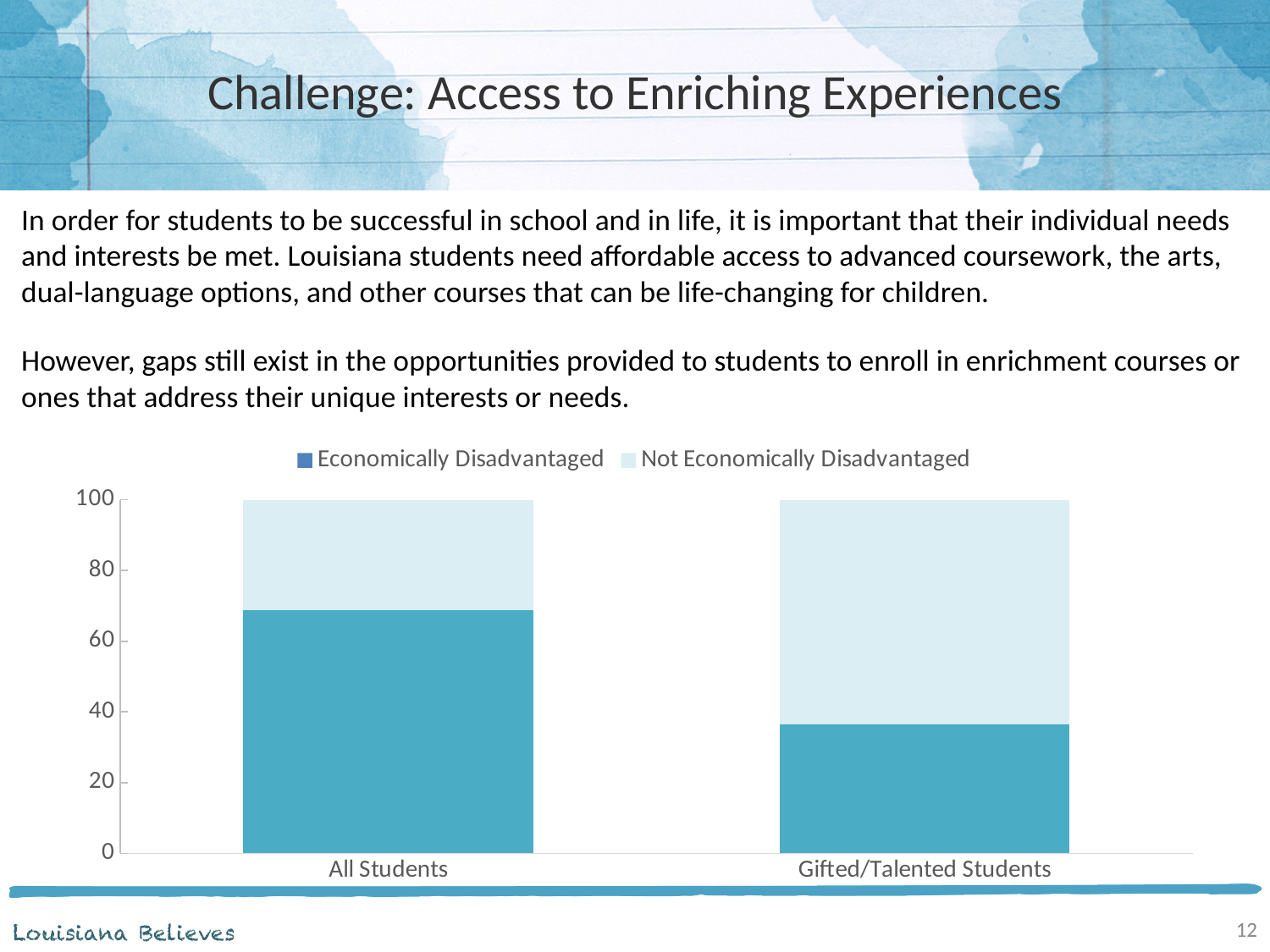
Is the Economically Disadvantaged value for All Students greater or less than 60? greater Is the Economically Disadvantaged value for Gifted/Talented Students greater or less than 40? less Which two series are listed in the chart's legend? Economically Disadvantaged and Not Economically Disadvantaged Is the Economically Disadvantaged value for All Students greater or less than 80? less Which category has the larger Not Economically Disadvantaged share: All Students or Gifted/Talented Students? Gifted/Talented Students How many categories are shown on the x axis of the chart? 2 Which series is shown in the darker blue colour in the chart? Economically Disadvantaged What is the total height of the stacked bar for All Students? 100 What kind of chart is shown on the slide? Stacked bar chart Which category has the larger Economically Disadvantaged share: All Students or Gifted/Talented Students? All Students How many series does the chart's legend list? 2